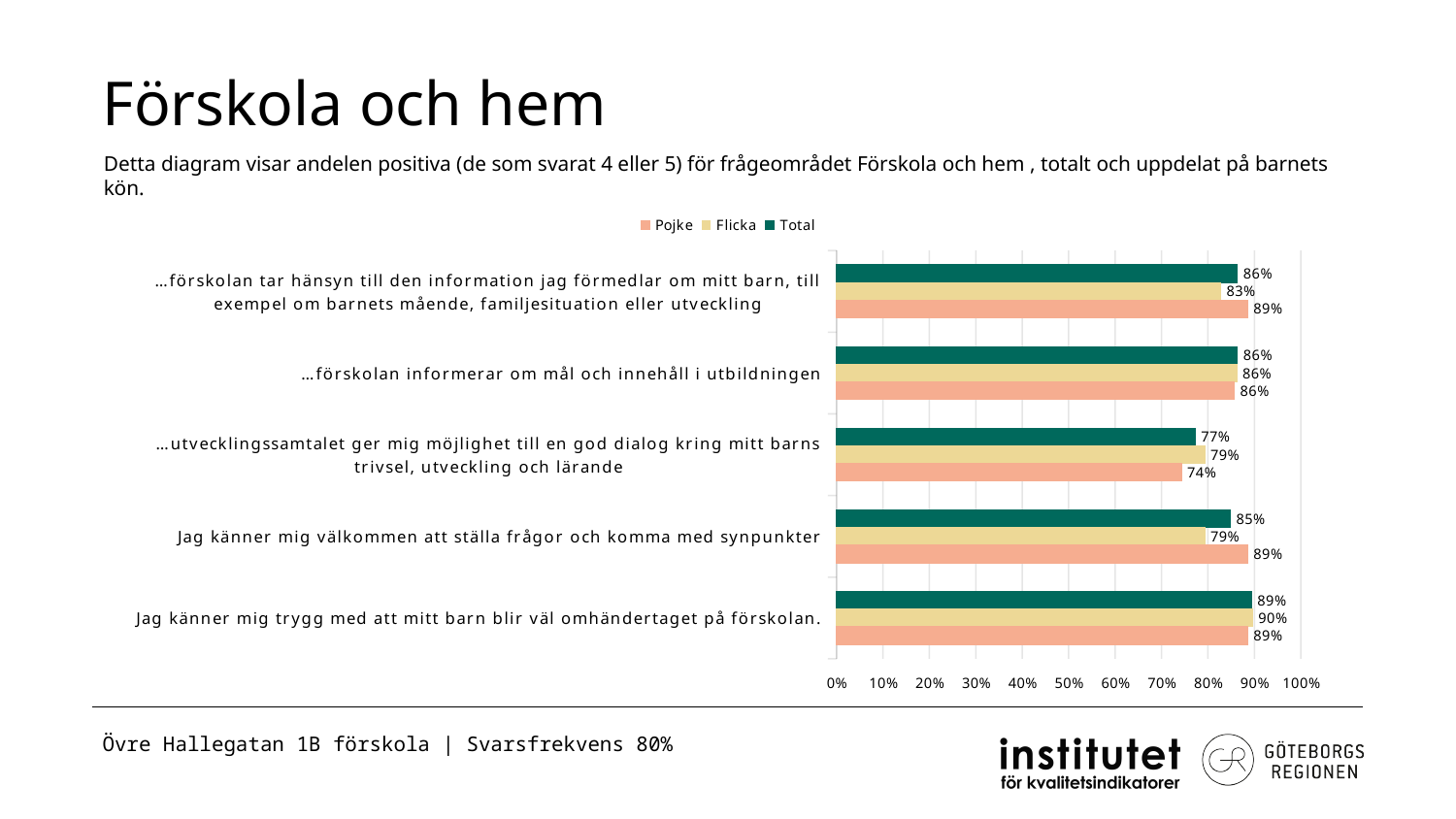
Is the Pojke value for "…utvecklingssamtalet ger mig möjlighet till en god dialog kring mitt barns trivsel, utveckling och lärande" greater or less than 80%? less What is the Flicka value for "…utvecklingssamtalet ger mig möjlighet till en god dialog kring mitt barns trivsel, utveckling och lärande"? 79% Which category has the lowest Total value? …utvecklingssamtalet ger mig möjlighet till en god dialog kring mitt barns trivsel, utveckling och lärande How many series does the legend list? 3 How many categories (statements) are shown in the chart? 5 For "…förskolan tar hänsyn till den information jag förmedlar om mitt barn, till exempel om barnets mående, familjesituation eller utveckling", which is larger, the Pojke value or the Flicka value? Pojke What kind of chart is shown on the slide? Bar chart Which category has the highest Total value? Jag känner mig trygg med att mitt barn blir väl omhändertaget på förskolan. Which series is shown in green in the legend? Total What is the difference between the Pojke and Flicka values for "Jag känner mig välkommen att ställa frågor och komma med synpunkter"? 10% What is the Pojke value for "Jag känner mig välkommen att ställa frågor och komma med synpunkter"? 89% What is the Total value for "Jag känner mig trygg med att mitt barn blir väl omhändertaget på förskolan."? 89%